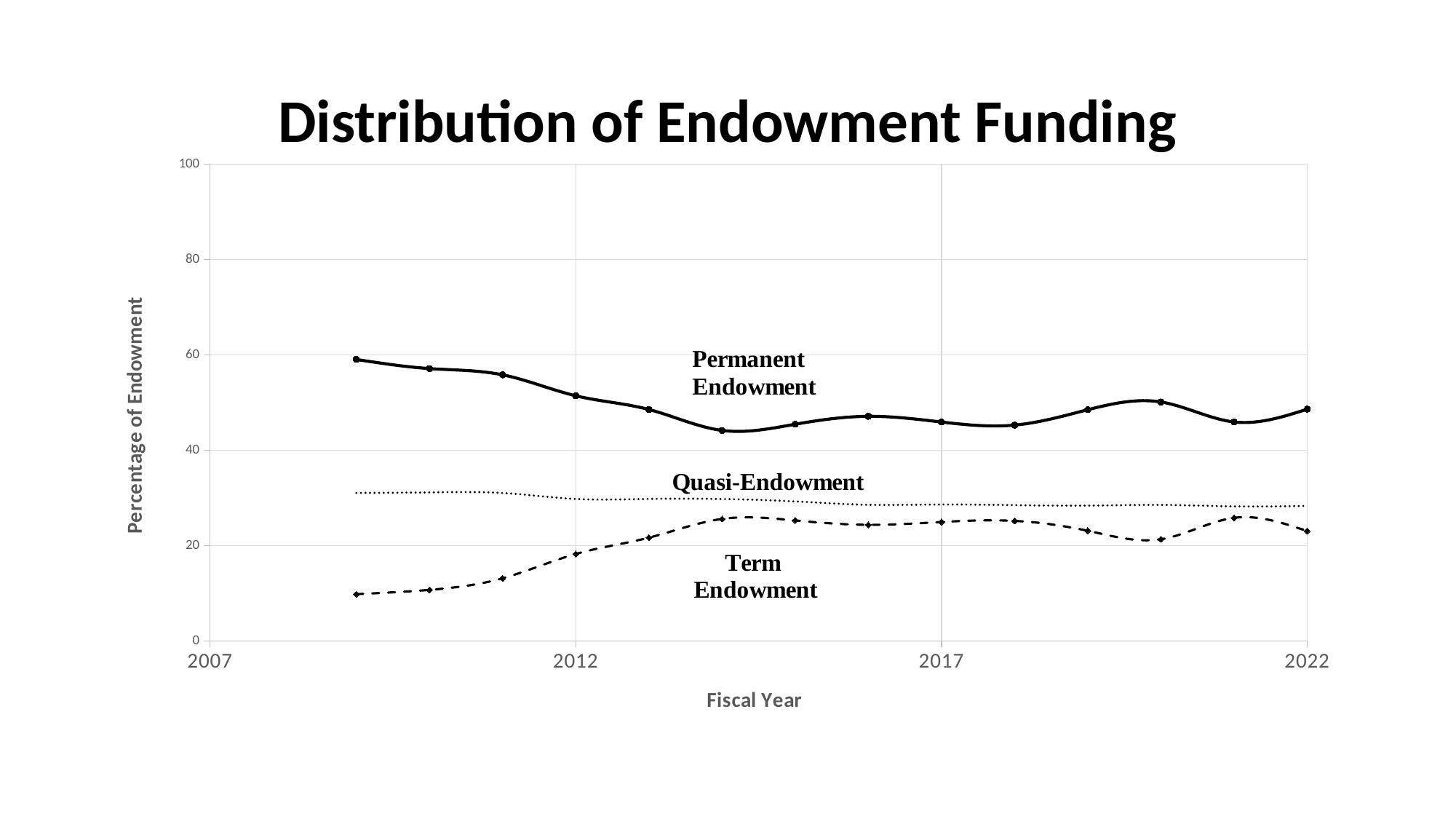
Which series has the lowest value in 2012? Term Endowment What is the title of the chart? Distribution of Endowment Funding Is the value for Permanent Endowment in 2012 greater or less than 40? greater What kind of chart is shown on the slide? line chart Which series has the highest value in 2022? Permanent Endowment In 2017, which is larger: Permanent Endowment or Quasi-Endowment? Permanent Endowment What is the label of the x axis? Fiscal Year How many data series are plotted on the chart? 3 Is the value for Permanent Endowment in 2022 greater or less than 60? less Is the value for Quasi-Endowment in 2017 greater or less than 40? less Does the Term Endowment line rise or fall between 2009 and 2014? rise